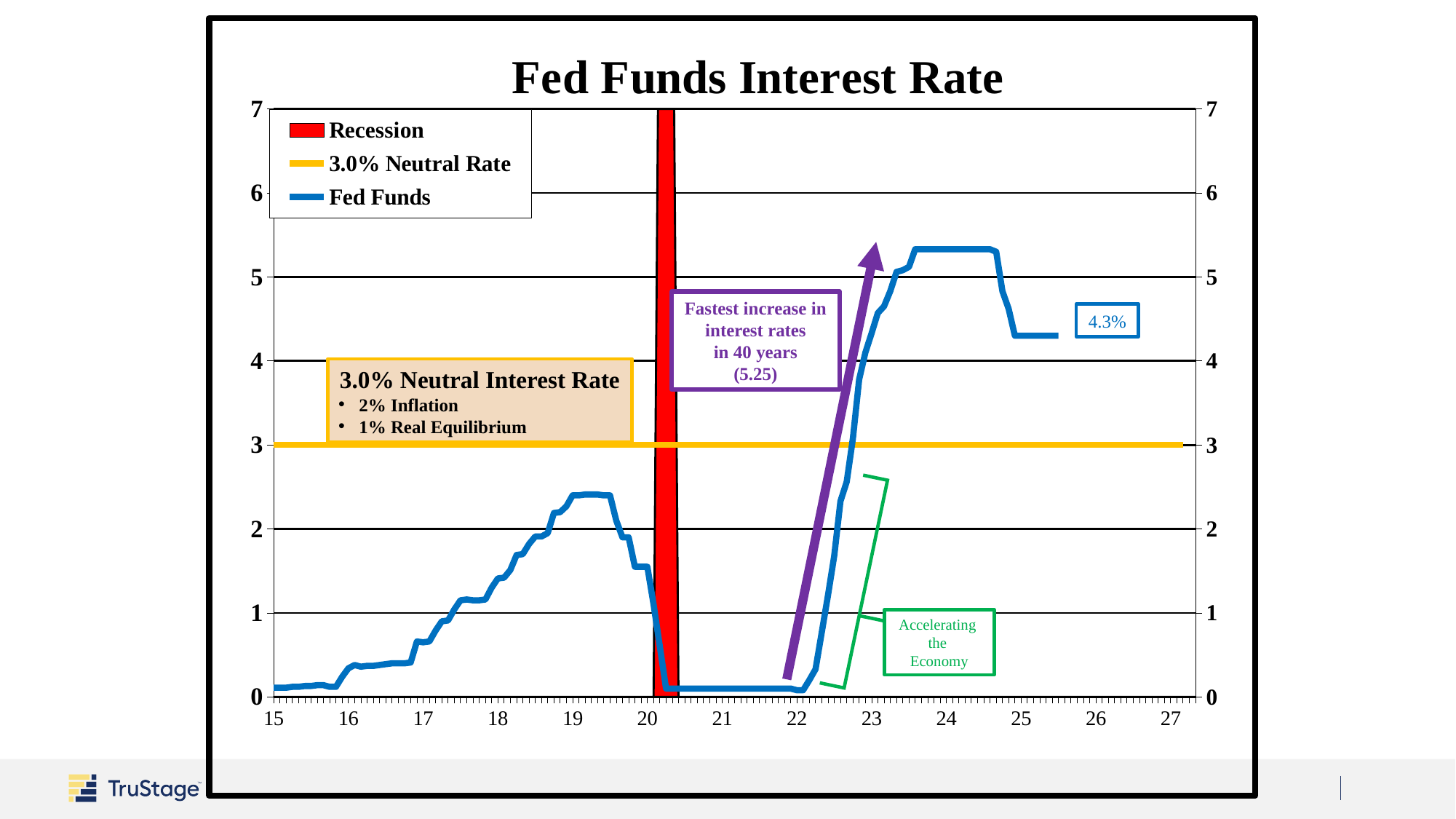
Does the Fed Funds rate rise or fall between 2022 and 2023? rise Is the Fed Funds rate in 2021 greater or less than 1? less Is the Fed Funds rate in 2024 greater or less than 5? greater How many entries does the chart legend list? 3 What is the level of the neutral rate line shown on the chart? 3.0% What type of chart is shown on the slide? line chart What is the title of the chart? Fed Funds Interest Rate What value is labeled at the end of the Fed Funds line? 4.3% Is the Fed Funds rate in 2019 greater or less than 3? less According to the annotation, what peak level did the Fed Funds rate reach during the fastest increase in 40 years? 5.25 Which is higher, the Fed Funds rate in 2024 or in 2019? 2024 What does the red shaded area on the chart represent? Recession